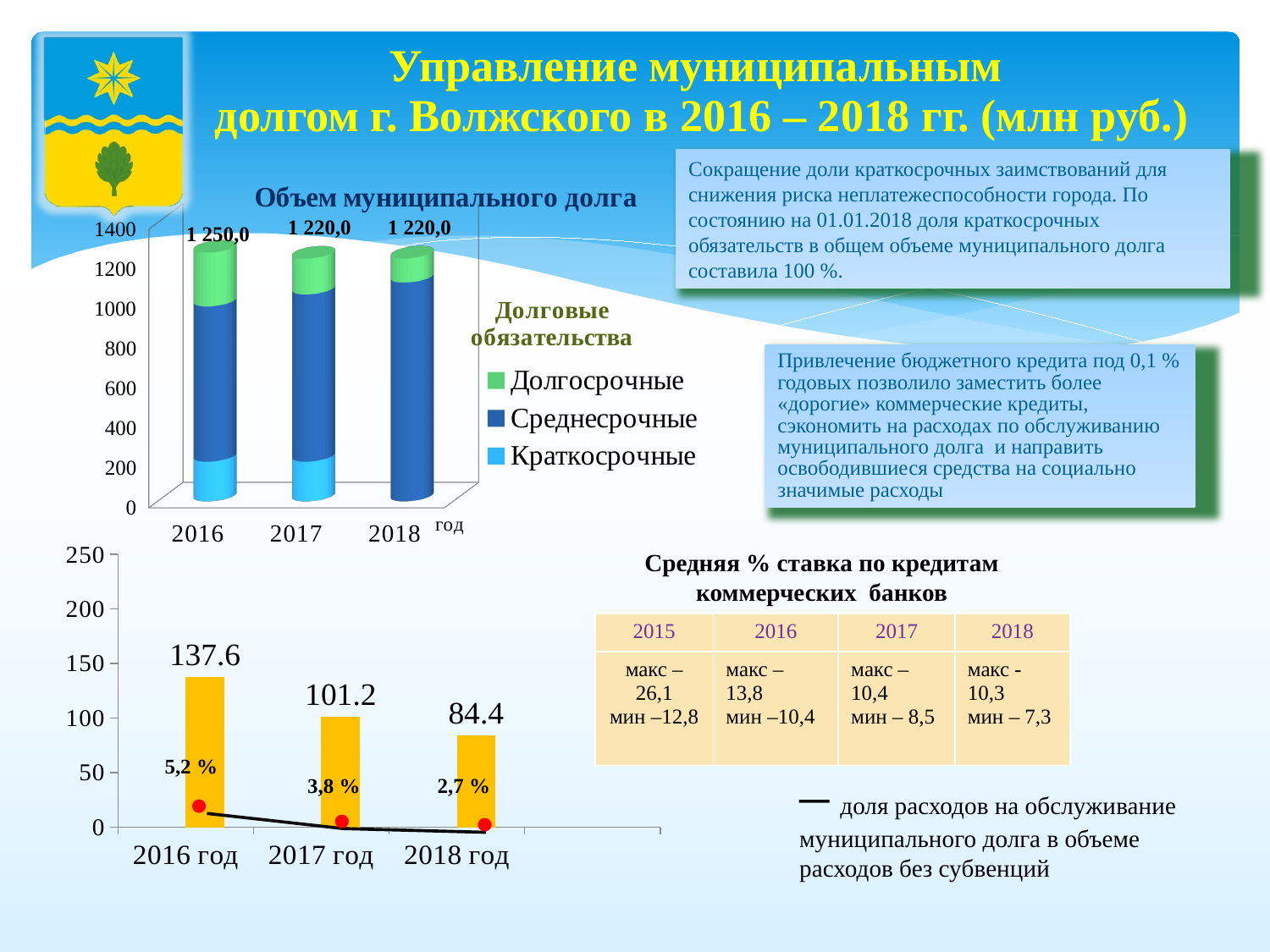
On the chart 'Объем муниципального долга', is the value of the 'Краткосрочные' segment for 2016 greater or less than 400? less On the bottom-left chart, what is the bar value for 2017 год? 101.2 On the chart 'Объем муниципального долга', what is the total municipal debt labelled for 2016? 1 250,0 On the bottom-left chart, which year has the lowest bar value? 2018 год On the chart 'Объем муниципального долга', what is the total labelled for 2018? 1 220,0 On the bottom-left chart, what is the bar value for 2018 год? 84.4 On the bottom-left chart, do the bar values rise or fall from 2016 год to 2018 год? fall On the chart 'Объем муниципального долга', what kind of chart is it? stacked bar chart On the chart 'Объем муниципального долга', how many series does the legend list? 3 On the chart 'Объем муниципального долга', which year has the highest total debt? 2016 On the bottom-left chart, what is the difference between the bar values for 2016 год and 2017 год? 36.4 On the bottom-left chart, what percentage is labelled on the line for 2016 год? 5,2 %